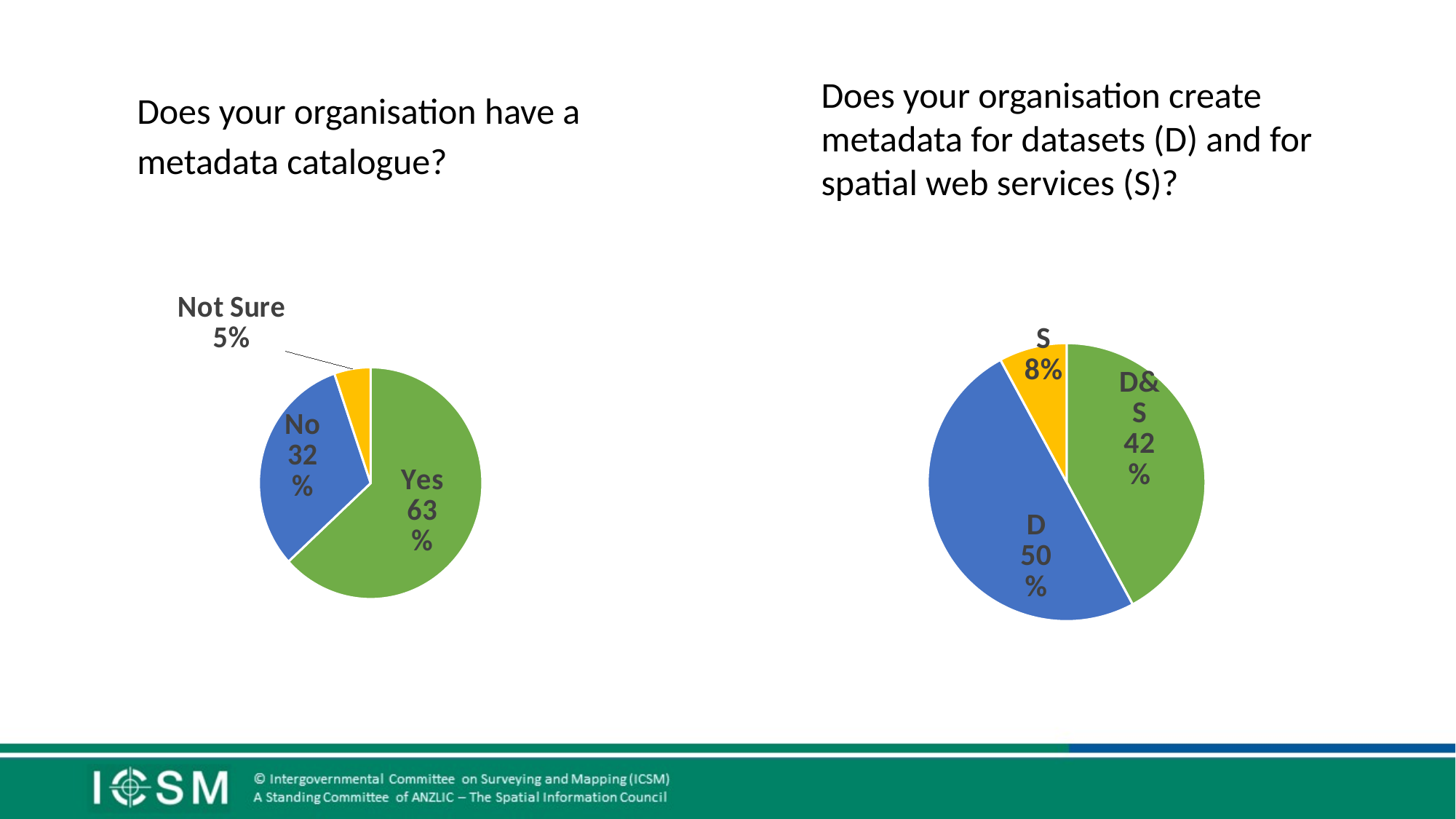
In the left pie chart (metadata catalogue), what share of respondents answered Yes? 63% In the right pie chart (metadata for datasets and spatial web services), what share is labelled D? 50% In the left pie chart (metadata catalogue), what share of respondents answered Not Sure? 5% In the right pie chart (metadata for datasets and spatial web services), what share is labelled D&S? 42% In the left pie chart (metadata catalogue), which answer has the smallest share? Not Sure What type of chart is used on the left side of the slide? Pie chart In the left pie chart (metadata catalogue), which answer has the largest share? Yes How many slices does the right pie chart (metadata for datasets and spatial web services) have? 3 In the right pie chart (metadata for datasets and spatial web services), what share is labelled S? 8% In the left pie chart (metadata catalogue), what share of respondents answered No? 32% In the left pie chart (metadata catalogue), what is the difference in percentage points between Yes and No? 31 In the right pie chart (metadata for datasets and spatial web services), which slice is larger, D or D&S? D